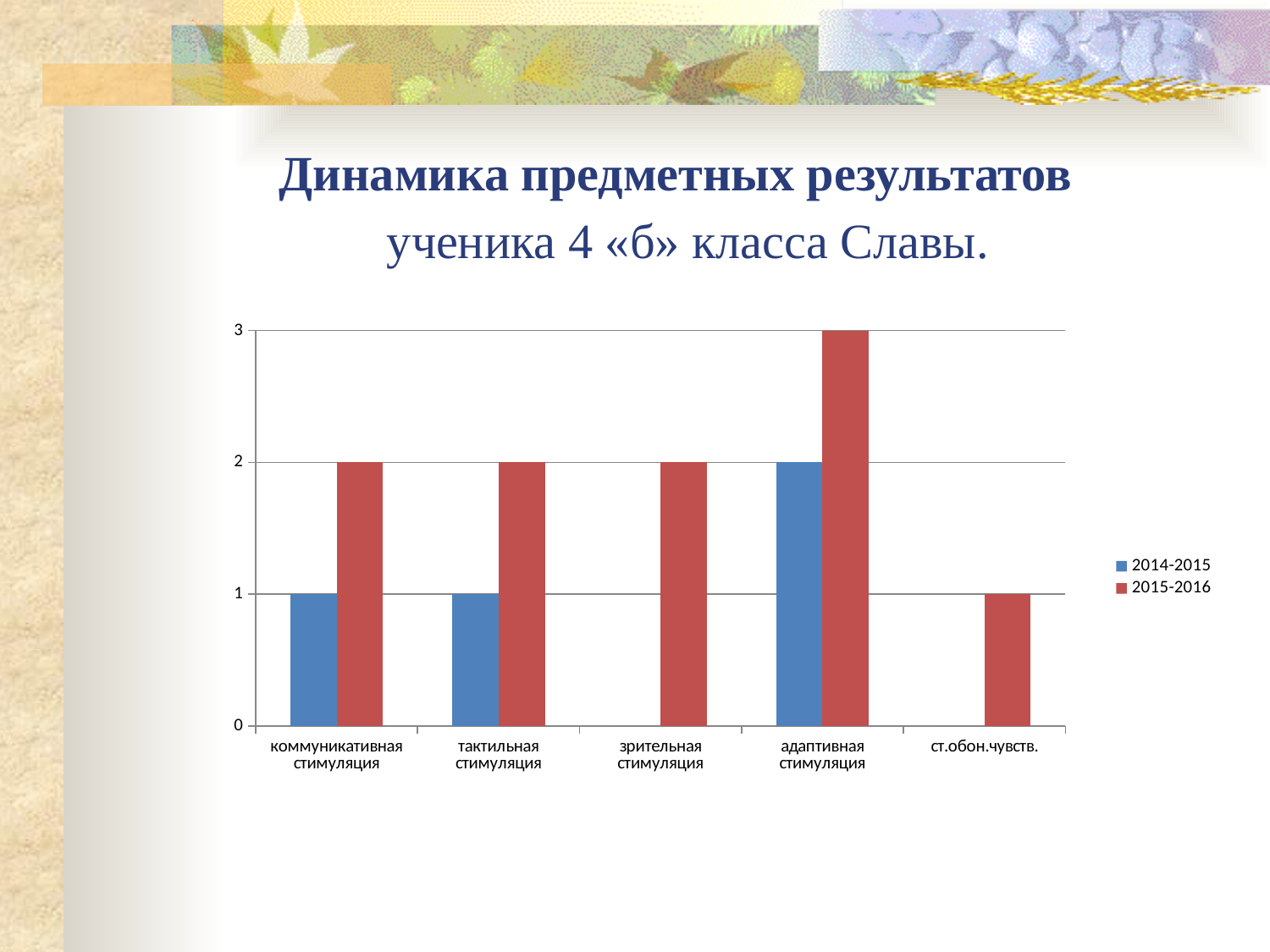
What is the value for адаптивная стимуляция in the 2015-2016 series? 3 Which is larger for зрительная стимуляция: the 2014-2015 value or the 2015-2016 value? 2015-2016 How many series does the legend list? 2 Which series is shown in red in the legend? 2015-2016 What is the difference between the 2015-2016 and 2014-2015 values for тактильная стимуляция? 1 Which category has the highest value in the 2015-2016 series? адаптивная стимуляция How many categories are shown on the x axis? 5 What is the value for коммуникативная стимуляция in the 2014-2015 series? 1 What is the value for адаптивная стимуляция in the 2014-2015 series? 2 What kind of chart is shown on the slide? bar chart What is the value for ст.обон.чувств. in the 2015-2016 series? 1 Which category has the lowest value in the 2015-2016 series? ст.обон.чувств.